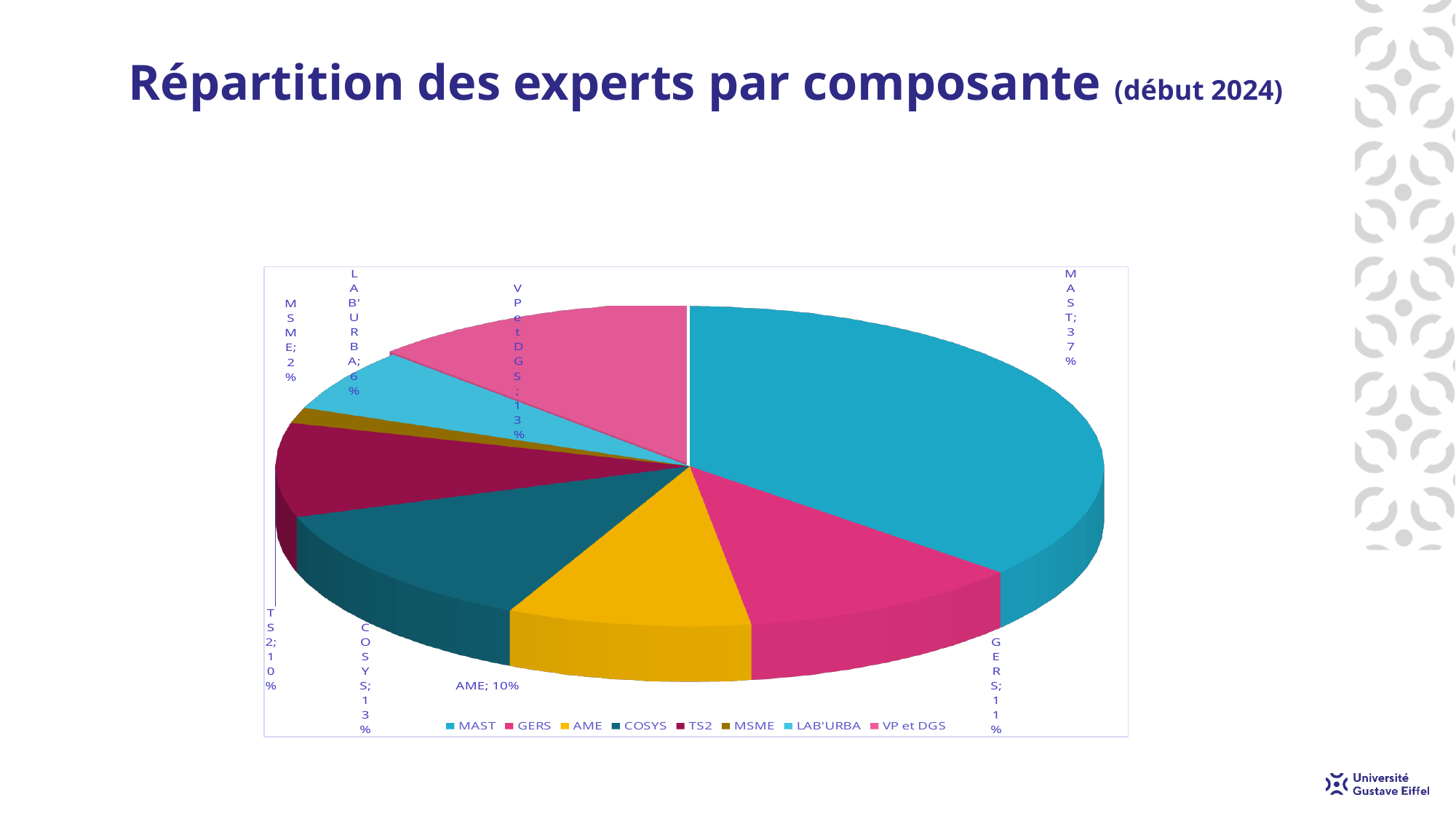
What is the title of the chart on the slide? Répartition des experts par composante (début 2024) Which component has the largest share of experts? MAST What share of experts belongs to MAST? 37% Which has a larger share, GERS or LAB'URBA? GERS What is the difference in percentage points between MAST and COSYS? 24 What percentage is shown for LAB'URBA? 6% What kind of chart is shown on the slide? pie chart What percentage is shown for GERS? 11% How many slices does the pie chart have? 8 How many entries does the legend list? 8 What percentage is shown for VP et DGS? 13% Which component has the smallest share of experts? MSME